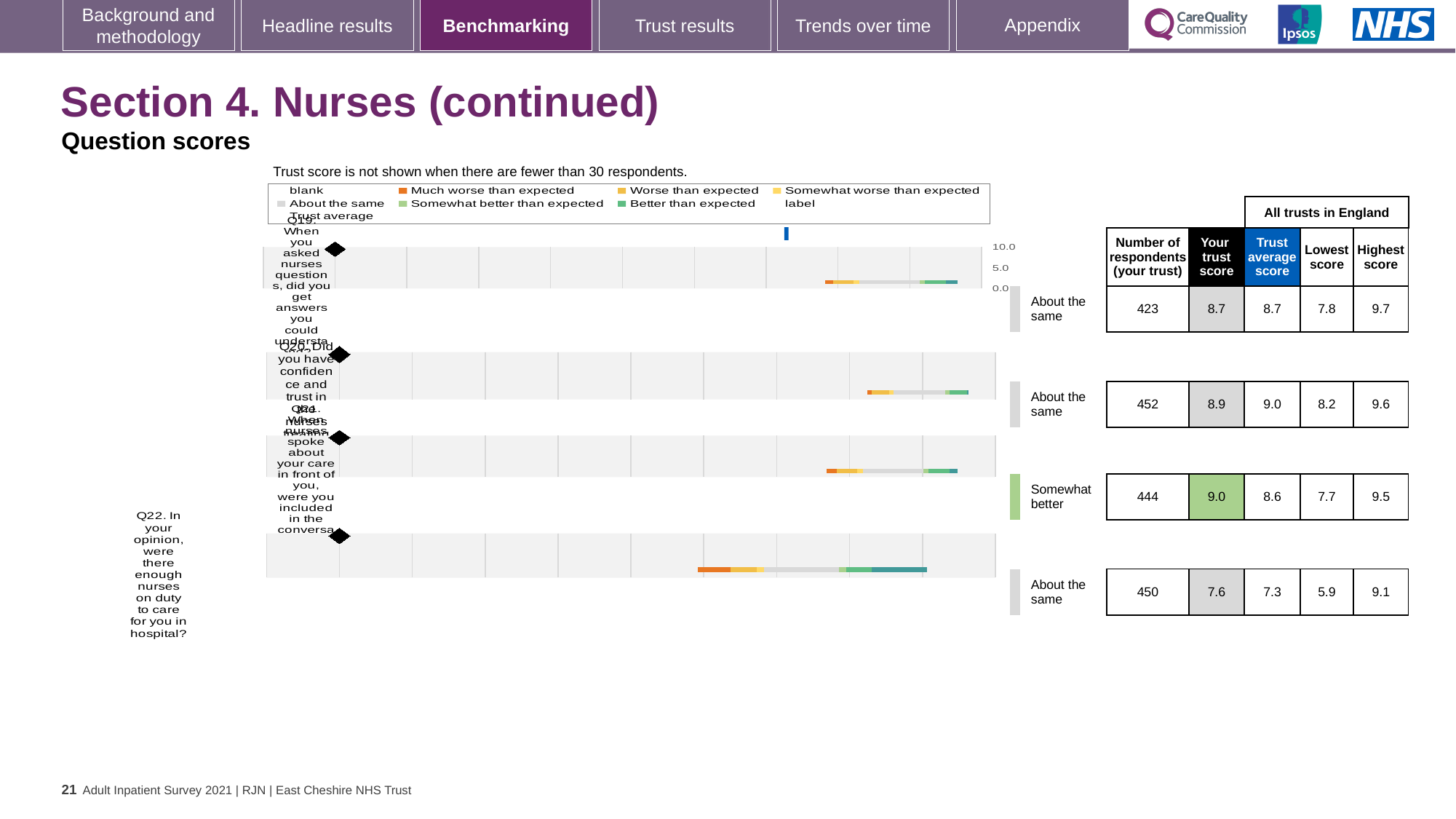
Which benchmark category is Q21 placed in? Somewhat better What colour represents 'Much worse than expected' in the legend? Orange For Q20, which is larger: the trust score or the trust average score? Trust average score How many respondents from the trust answered Q20? 452 What kind of chart is used to show the question scores on this slide? bar chart Which question has the lowest trust score? Q22 What is the trust score for Q22 (were there enough nurses on duty)? 7.6 By how much does the trust score for Q21 exceed the trust average score? 0.4 Which question has the highest trust score? Q21 What is the trust average score for Q19? 8.7 How many questions are plotted in the chart? 4 What is the difference between the highest score and the lowest score across all trusts in England for Q22? 3.2